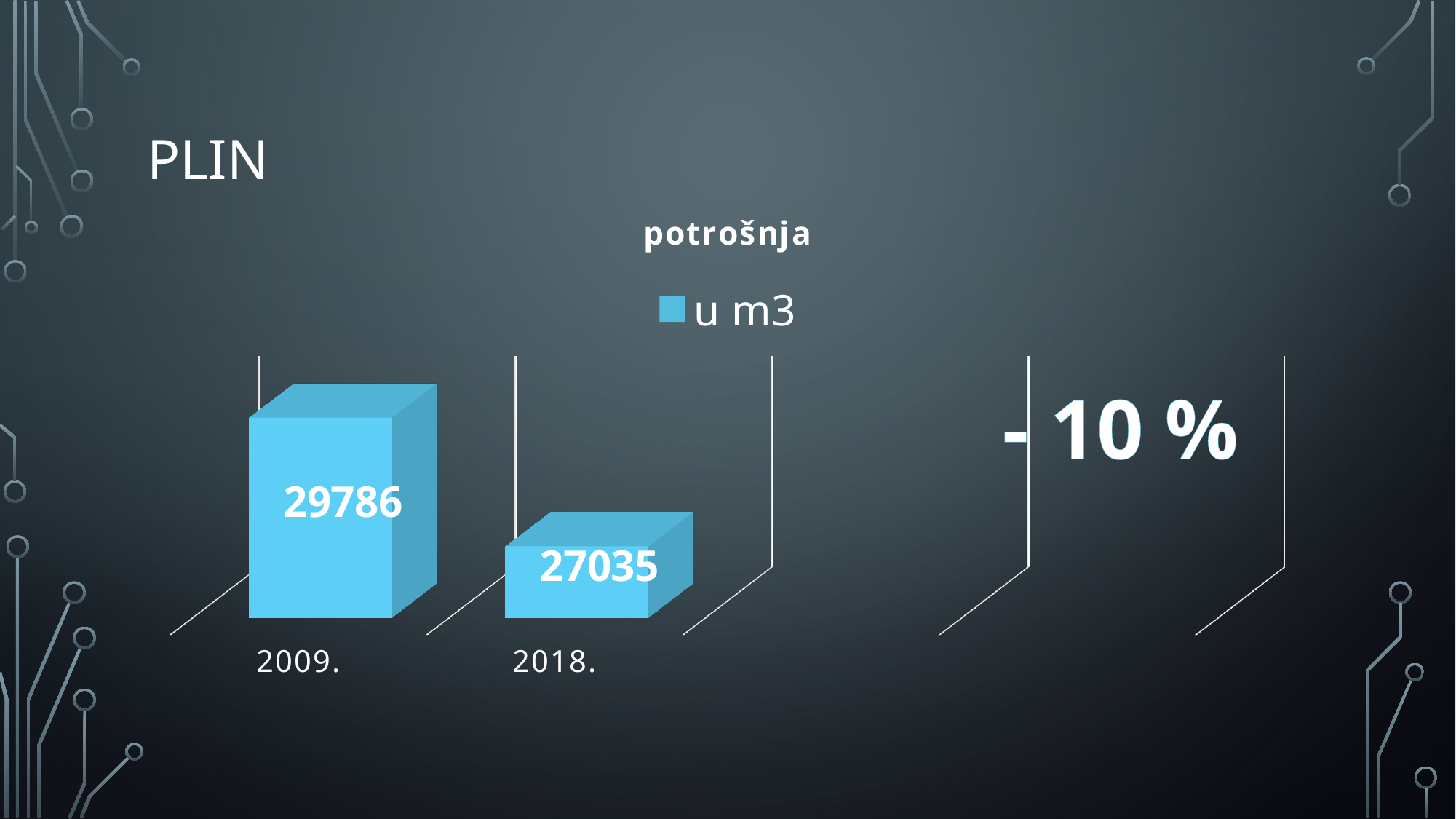
How many series does the legend of the potrošnja chart list? 1 What is the title of the chart? potrošnja What kind of chart is shown on the slide? bar chart What is the value for 2018. in the potrošnja chart? 27035 What is the difference between the 2009. and 2018. values in the potrošnja chart? 2751 Which year has the higher value in the potrošnja chart? 2009. How many categories are shown on the x axis of the potrošnja chart? 2 What is the legend entry of the chart? u m3 Which year has the lower value in the potrošnja chart? 2018. What is the value for 2009. in the potrošnja chart? 29786 Is the value for 2009. larger or smaller than the value for 2018.? larger Do the values rise or fall from 2009. to 2018. in the potrošnja chart? fall